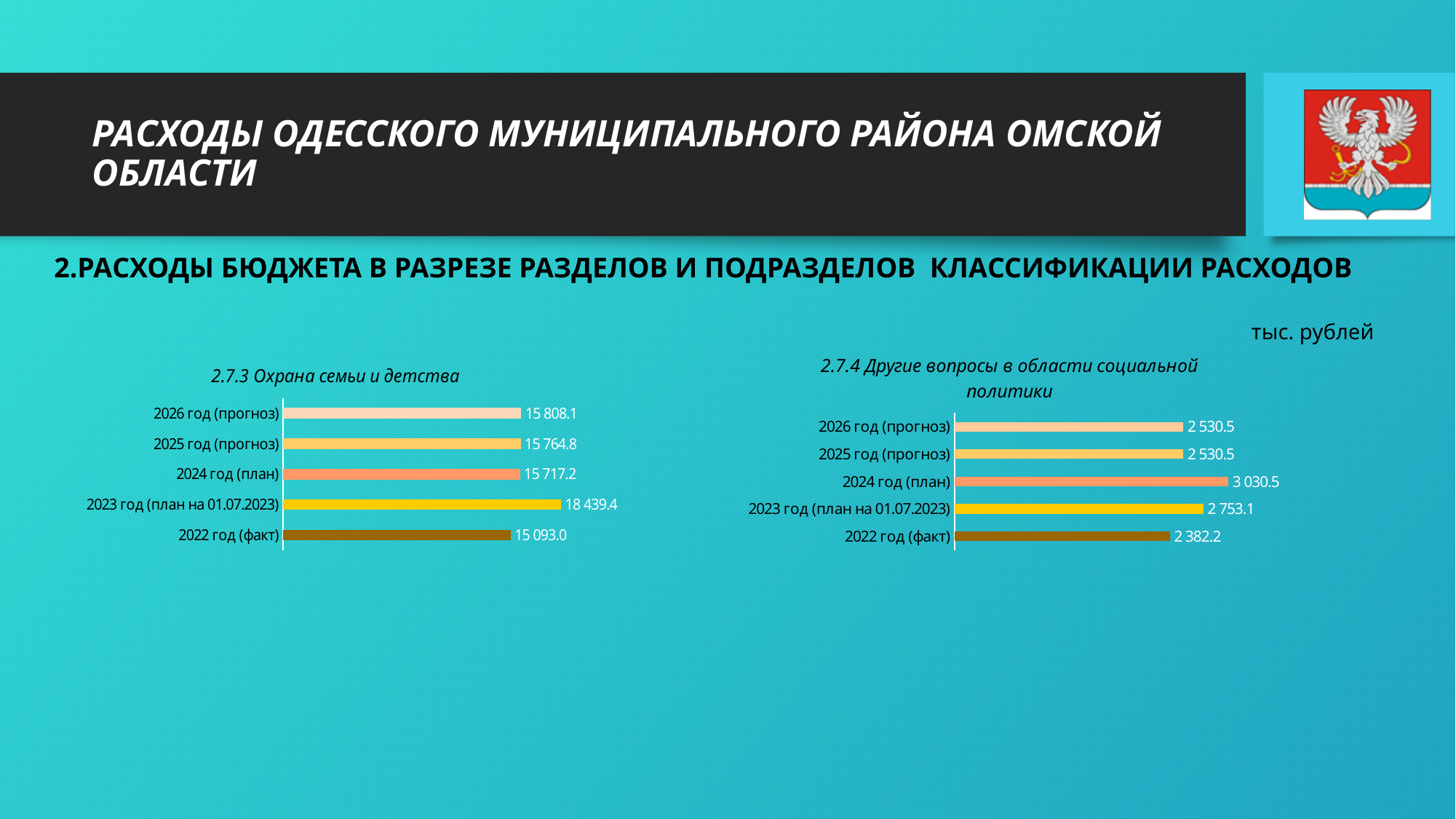
In the chart '2.7.3 Охрана семьи и детства', what is the value for 2023 год (план на 01.07.2023)? 18 439.4 In the chart '2.7.3 Охрана семьи и детства', which category has the lowest value? 2022 год (факт) What type of chart is '2.7.4 Другие вопросы в области социальной политики'? Bar chart In the chart '2.7.3 Охрана семьи и детства', which category has the highest value? 2023 год (план на 01.07.2023) In the chart '2.7.4 Другие вопросы в области социальной политики', which is larger: the value for 2023 год (план на 01.07.2023) or 2022 год (факт)? 2023 год (план на 01.07.2023) In the chart '2.7.3 Охрана семьи и детства', what is the value for 2022 год (факт)? 15 093.0 In the chart '2.7.4 Другие вопросы в области социальной политики', which category has the highest value? 2024 год (план) In the chart '2.7.4 Другие вопросы в области социальной политики', what is the value for 2022 год (факт)? 2 382.2 In the chart '2.7.3 Охрана семьи и детства', what is the difference between the values for 2026 год (прогноз) and 2025 год (прогноз)? 43.3 How many categories does the chart '2.7.3 Охрана семьи и детства' show? 5 In the chart '2.7.4 Другие вопросы в области социальной политики', what is the value for 2024 год (план)? 3 030.5 In the chart '2.7.4 Другие вопросы в области социальной политики', what is the difference between the values for 2024 год (план) and 2023 год (план на 01.07.2023)? 277.4